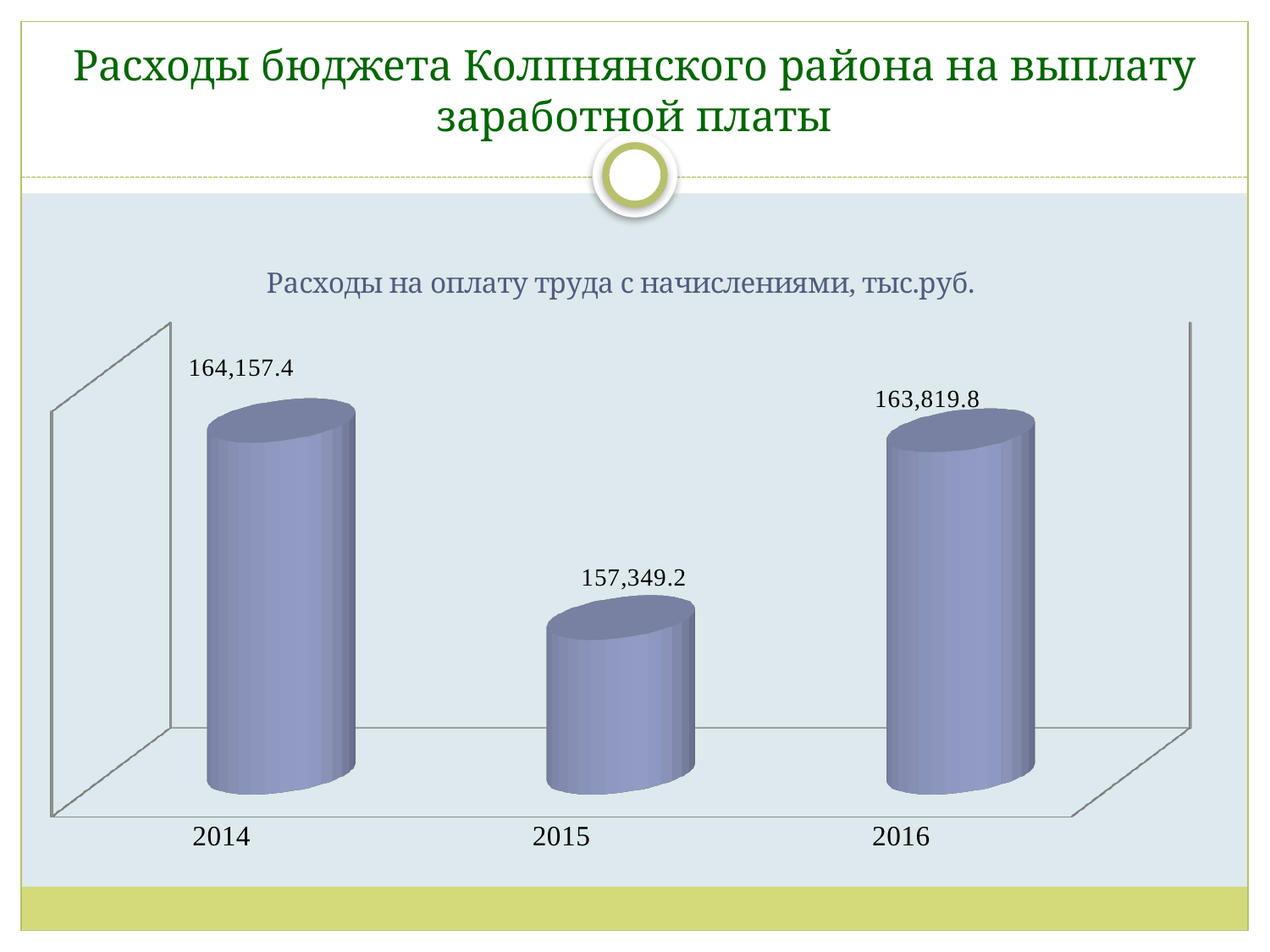
What is the value for 2014? 164,157.4 What is the difference between the values for 2016 and 2015? 6,470.6 Which is larger, the value for 2015 or the value for 2016? 2016 What is the value for 2016? 163,819.8 What is the title of the chart? Расходы на оплату труда с начислениями, тыс.руб. What is the difference between the values for 2014 and 2015? 6,808.2 How many years are shown on the chart? 3 Which year has the highest value? 2014 What kind of chart is shown on the slide? bar chart What is the difference between the values for 2014 and 2016? 337.6 What is the value for 2015? 157,349.2 Which year has the lowest value? 2015